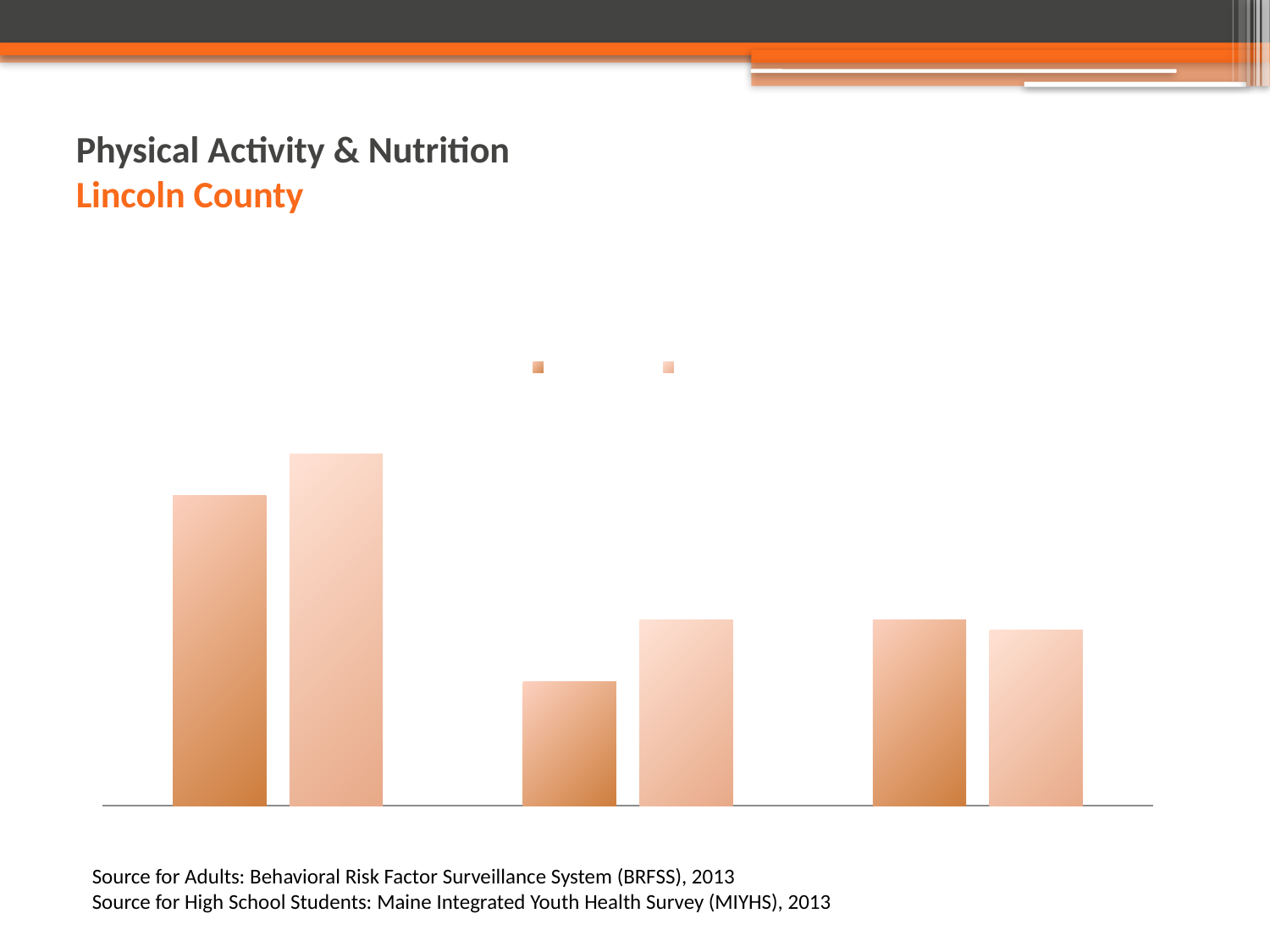
Which group of bars contains the shortest bar on the chart: the leftmost, middle, or rightmost? the middle In the middle group of bars, is the darker bar or the lighter bar taller? the lighter bar Which group of bars contains the tallest bar on the chart: the leftmost, middle, or rightmost? the leftmost How many groups of bars are plotted on the chart? 3 What kind of chart is shown on the slide? bar chart How many series does the chart's legend list? 2 In the rightmost group of bars, is the darker bar or the lighter bar taller? the darker bar What colour family are the bars on the chart? orange In the leftmost group of bars, is the darker bar or the lighter bar taller? the lighter bar